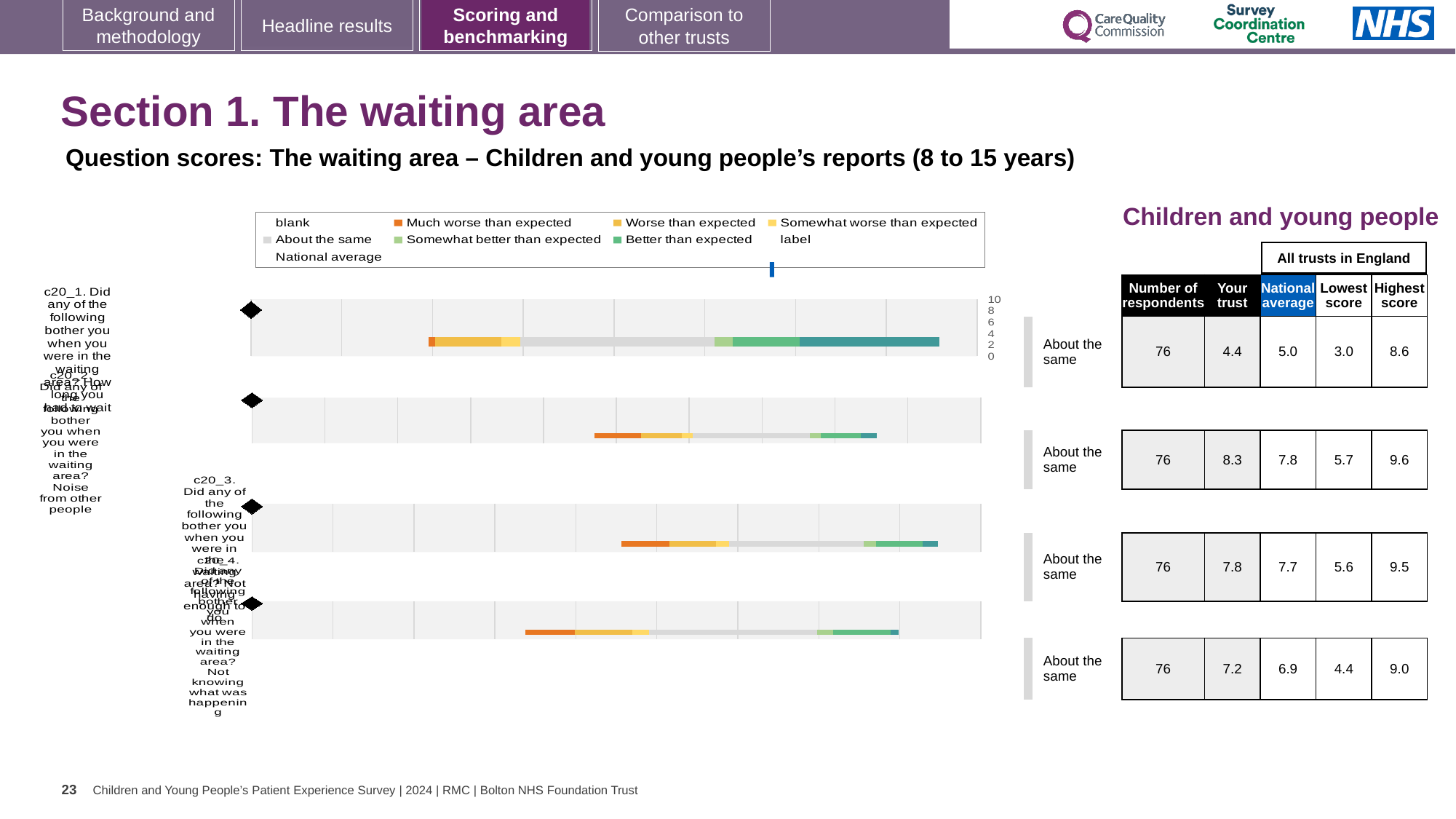
In the table, what is the highest score among all trusts in England for the second question (c20_2)? 9.6 Which question row has the highest 'Your trust' score in the table? c20_2 For the first question (c20_1), which is larger: the 'Your trust' score or the national average? National average What is the maximum value shown on the score axis of the bar charts? 10 In the table, what is the number of respondents for the first question (c20_1)? 76 What kind of chart is used to show the question scores on this slide? bar chart How many question bar charts are shown on the slide? 4 In the chart legend, what colour represents 'Much worse than expected'? orange In the table, what is the national average for the fourth question (c20_4, not knowing what was happening)? 6.9 For the second question (c20_2), what is the difference between the 'Your trust' score and the national average? 0.5